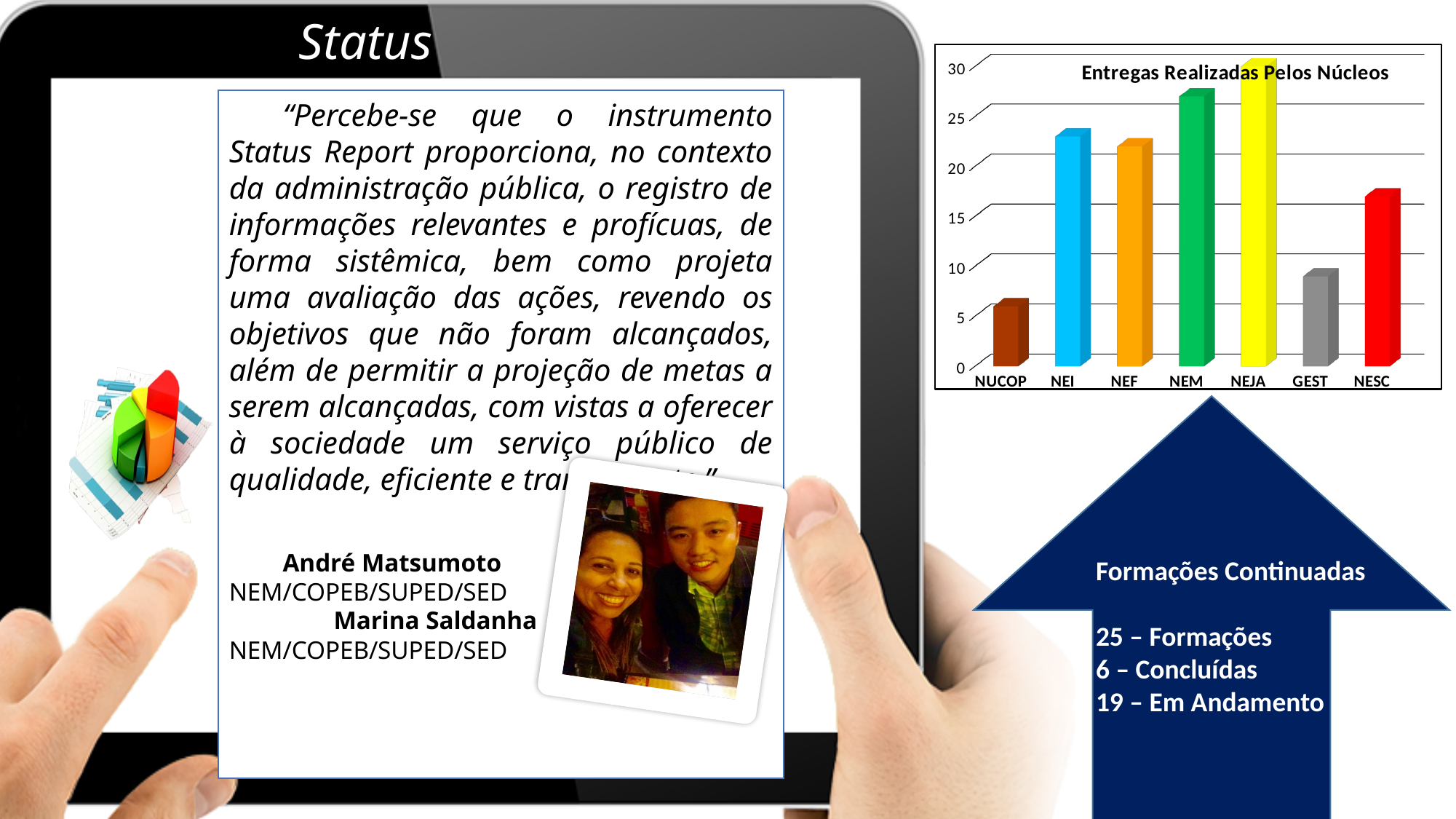
Is the value for NEI greater or less than 20? greater Is the value for NUCOP greater or less than 10? less Which category has the lowest bar in the chart? NUCOP Which is larger, the value for NEM or the value for NESC? NEM Which category has the highest bar in the chart? NEJA How many categories are shown on the x axis of the chart? 7 What is the title of the chart? Entregas Realizadas Pelos Núcleos Is the value for NESC greater or less than 15? greater What kind of chart is shown on the slide? bar chart What colour is the bar for NEJA? yellow